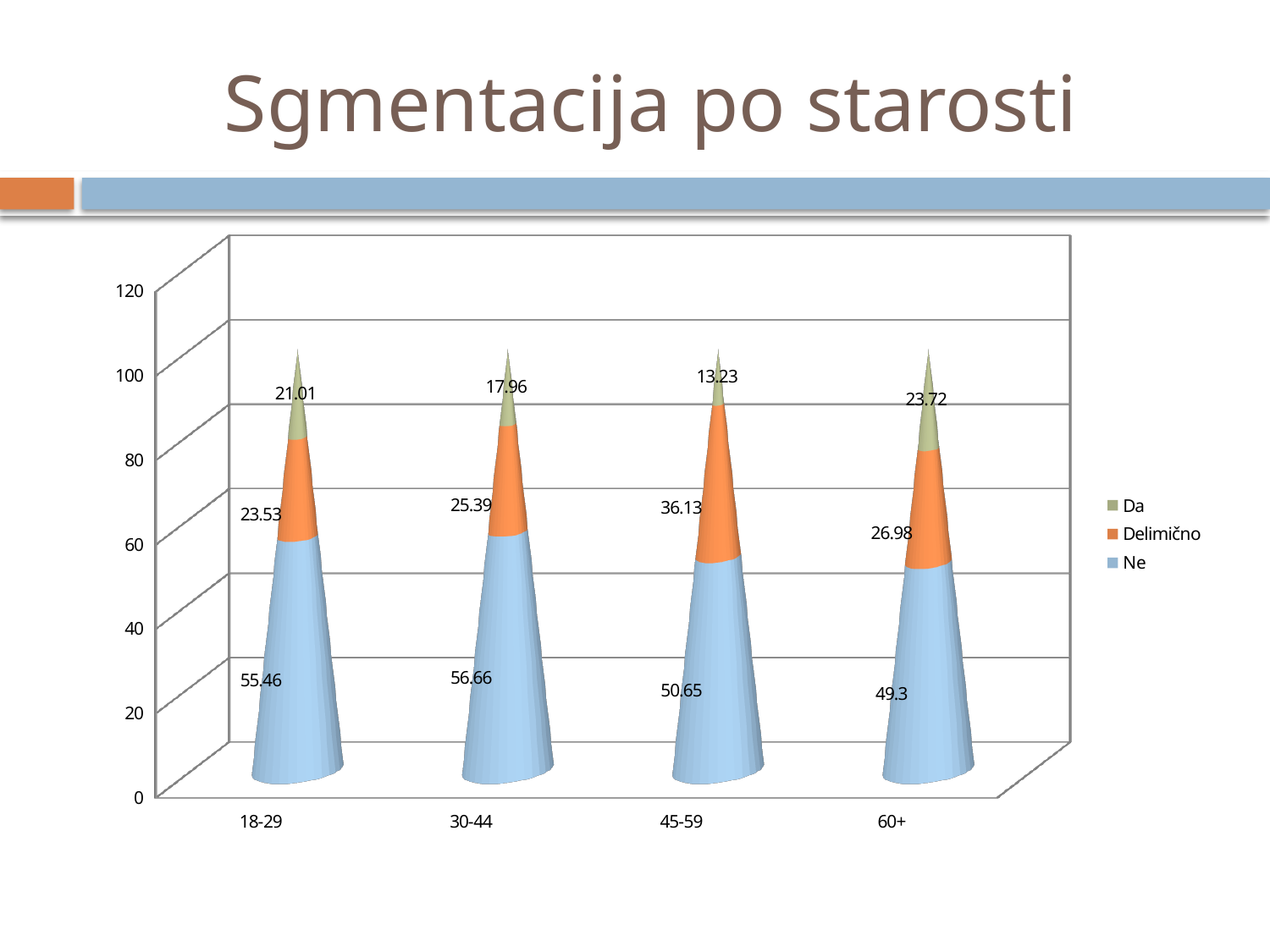
What is the value of the Da series for the 60+ age group? 23.72 How many age groups are shown on the x axis? 4 What is the difference between the Ne values for the 30-44 and 60+ age groups? 7.36 Which is larger: the Da value for 18-29 or the Da value for 30-44? 18-29 Which age group has the lowest value for the Ne series? 60+ What kind of chart is shown on the slide? Stacked bar chart What is the value of the Delimično series for the 30-44 age group? 25.39 How many series does the legend list? 3 Which age group has the lowest value for the Da series? 45-59 Which age group has the highest value for the Delimično series? 45-59 What is the total of the stacked bar for the 18-29 age group? 100 What is the value of the Ne series for the 45-59 age group? 50.65